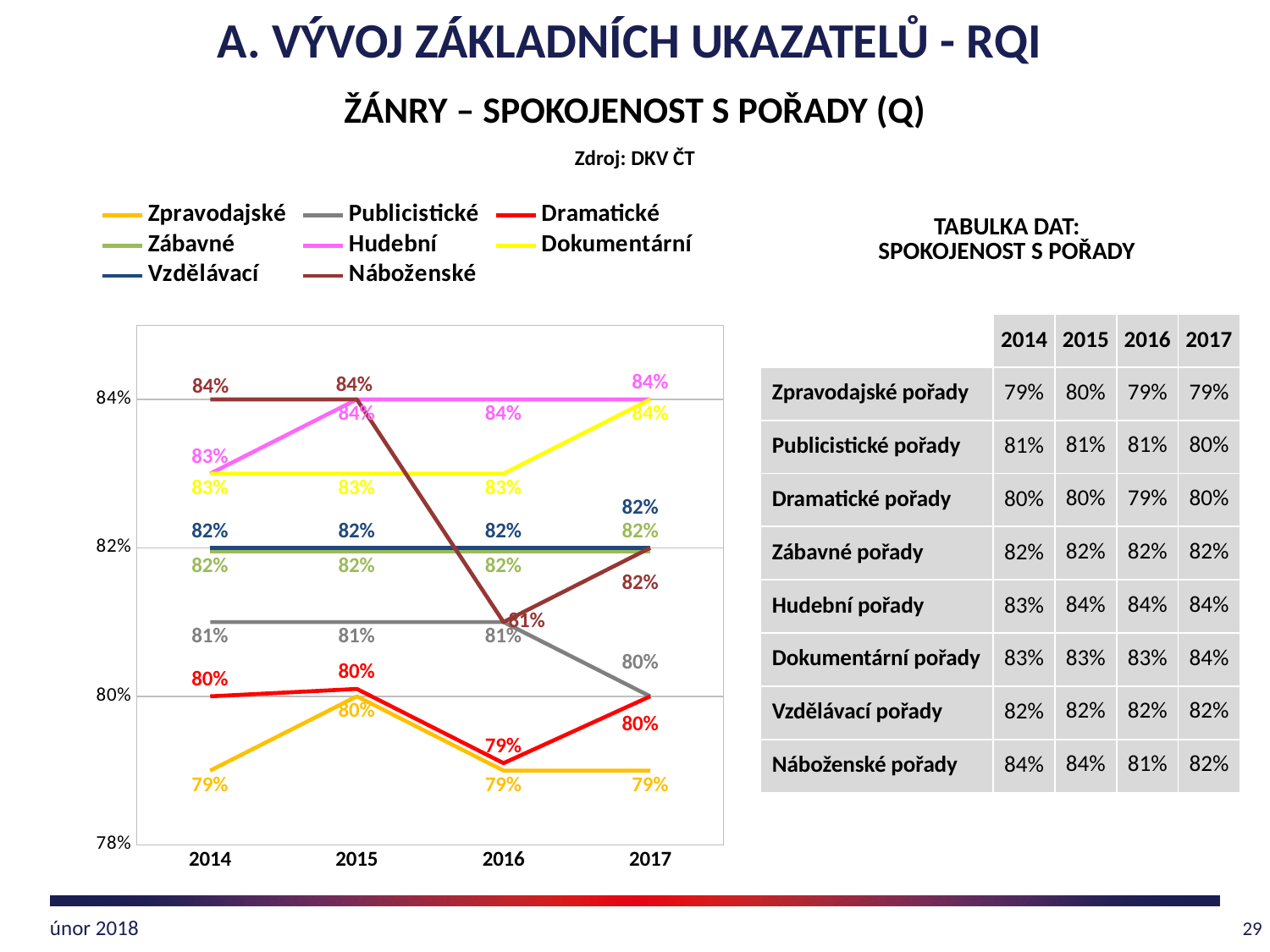
Does the value for Náboženské rise or fall from 2014 to 2016? fall How many series does the chart legend list? 8 Which series has the highest value in 2014? Náboženské How many years are shown on the x axis of the chart? 4 What is the value for Náboženské in 2016? 81% What is the value for Hudební in 2014? 83% Which is larger in 2015, the value for Hudební or the value for Dokumentární? Hudební What is the value for Publicistické in 2017? 80% What colour is the Dramatické line in the chart legend? red Which series has the lowest value in 2014? Zpravodajské What kind of chart is shown on the slide? line chart By how many percentage points did the value for Náboženské fall from 2015 to 2016? 3 percentage points